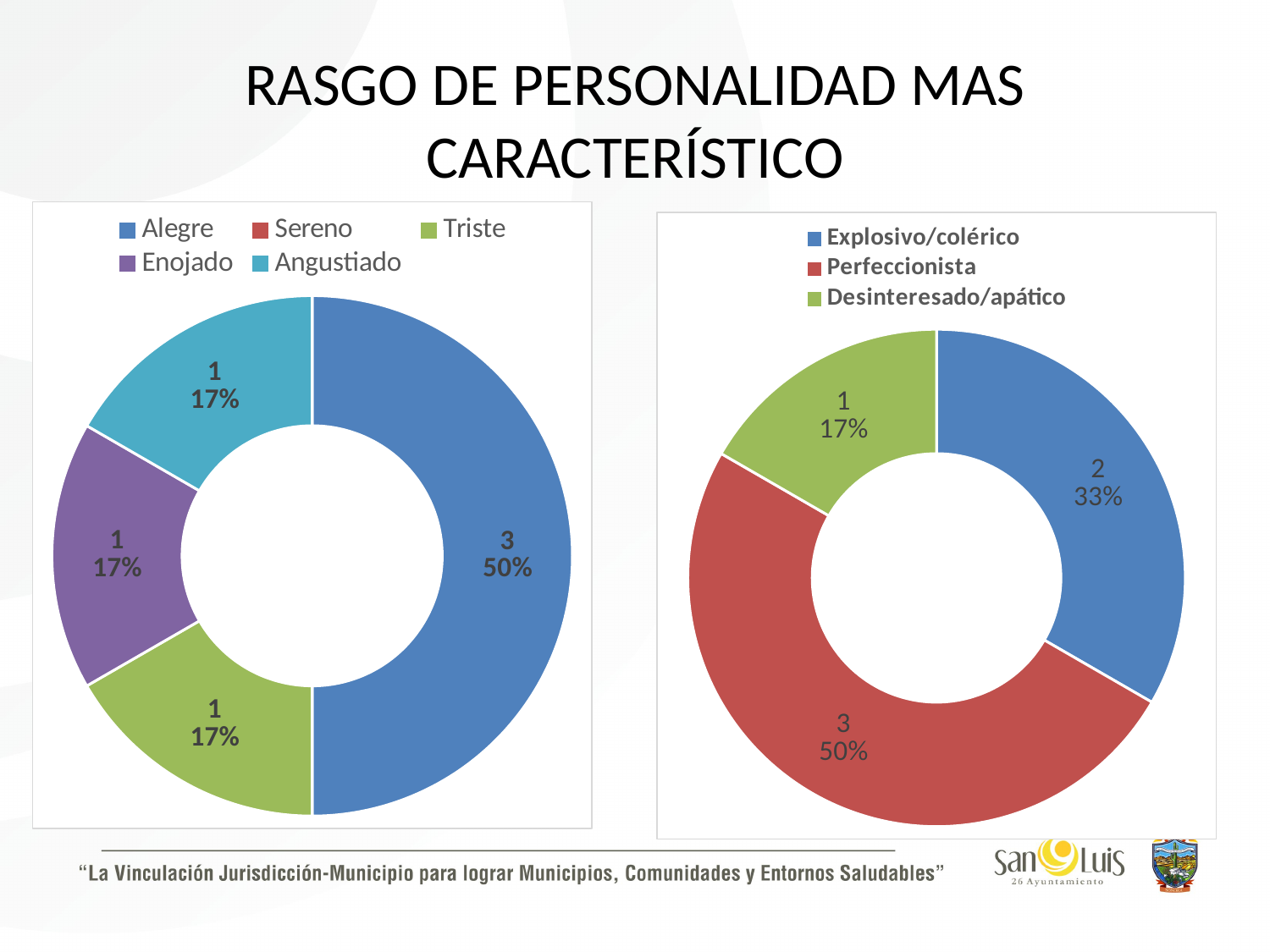
In the left chart, what is the count value shown for Alegre? 3 In the left chart, which category has the largest slice? Alegre How many slices are shown in the right chart? 3 In the right chart, what is the count value shown for Explosivo/colérico? 2 What type of chart is the left chart on the slide? doughnut chart In the left chart, what share of the doughnut does Alegre represent? 50% In the right chart, which category has the smallest slice? Desinteresado/apático In the right chart, which is larger: the slice for Explosivo/colérico or the slice for Perfeccionista? Perfeccionista How many entries does the legend of the left chart list? 5 In the right chart, what percentage is shown for Perfeccionista? 50% In the left chart, what percentage is shown for Angustiado? 17% In the right chart, what is the difference between the count for Perfeccionista and the count for Desinteresado/apático? 2